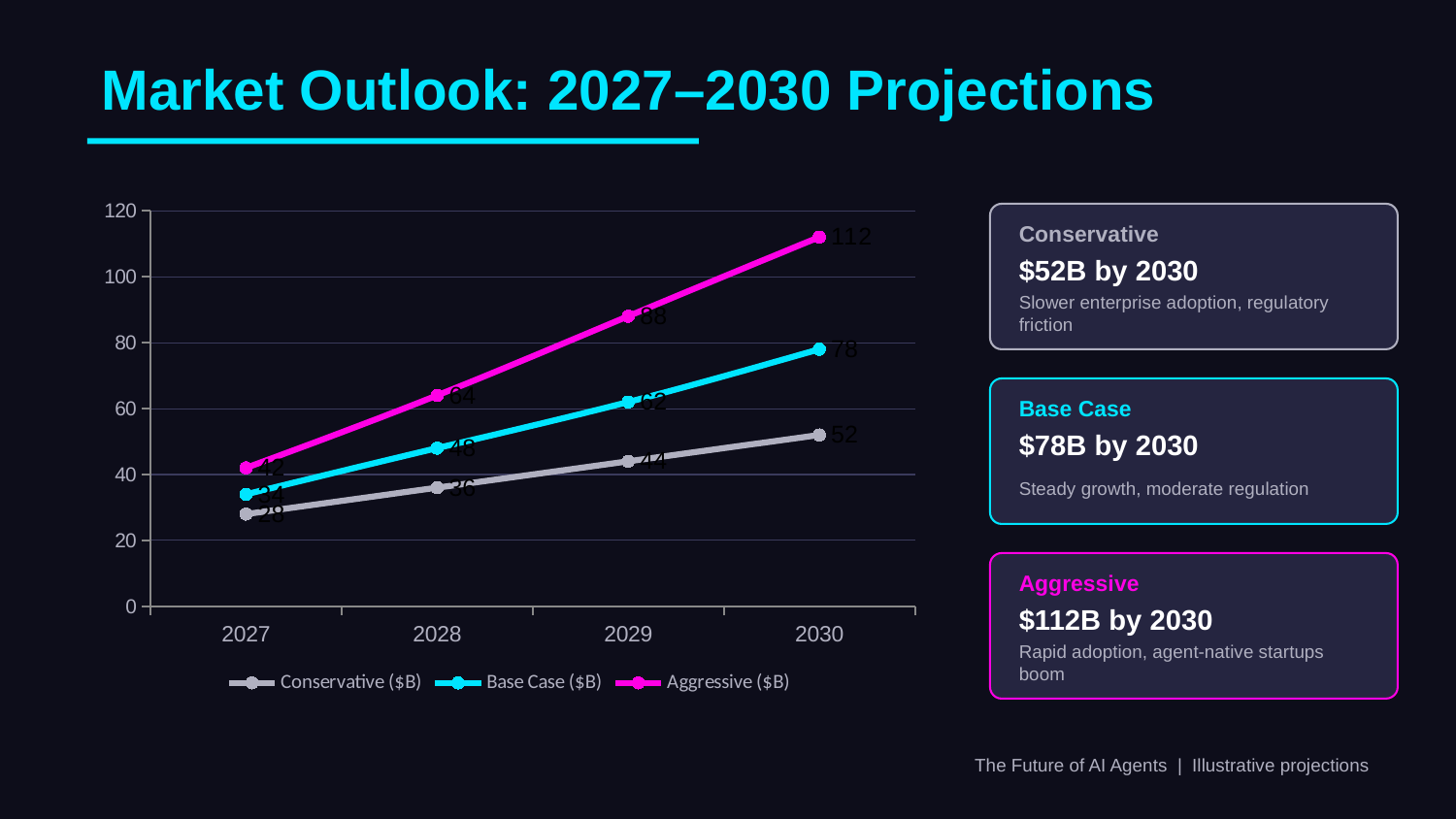
Which series has the highest value in 2030? Aggressive ($B) What is the Base Case ($B) value for 2028? 48 What is the Conservative ($B) value for 2027? 28 What is the difference between the Aggressive ($B) and Conservative ($B) values in 2030? 60 Which series has the lowest value in 2029? Conservative ($B) Do the Base Case ($B) values rise or fall from 2027 to 2030? Rise What is the Aggressive ($B) value for 2030? 112 What type of chart is shown on the slide? Line chart How many years are plotted along the x axis? 4 How many series does the chart legend list? 3 Which is larger in 2029: the Base Case ($B) value or the Conservative ($B) value? Base Case ($B) Is the Aggressive ($B) value for 2029 greater or less than 80? greater